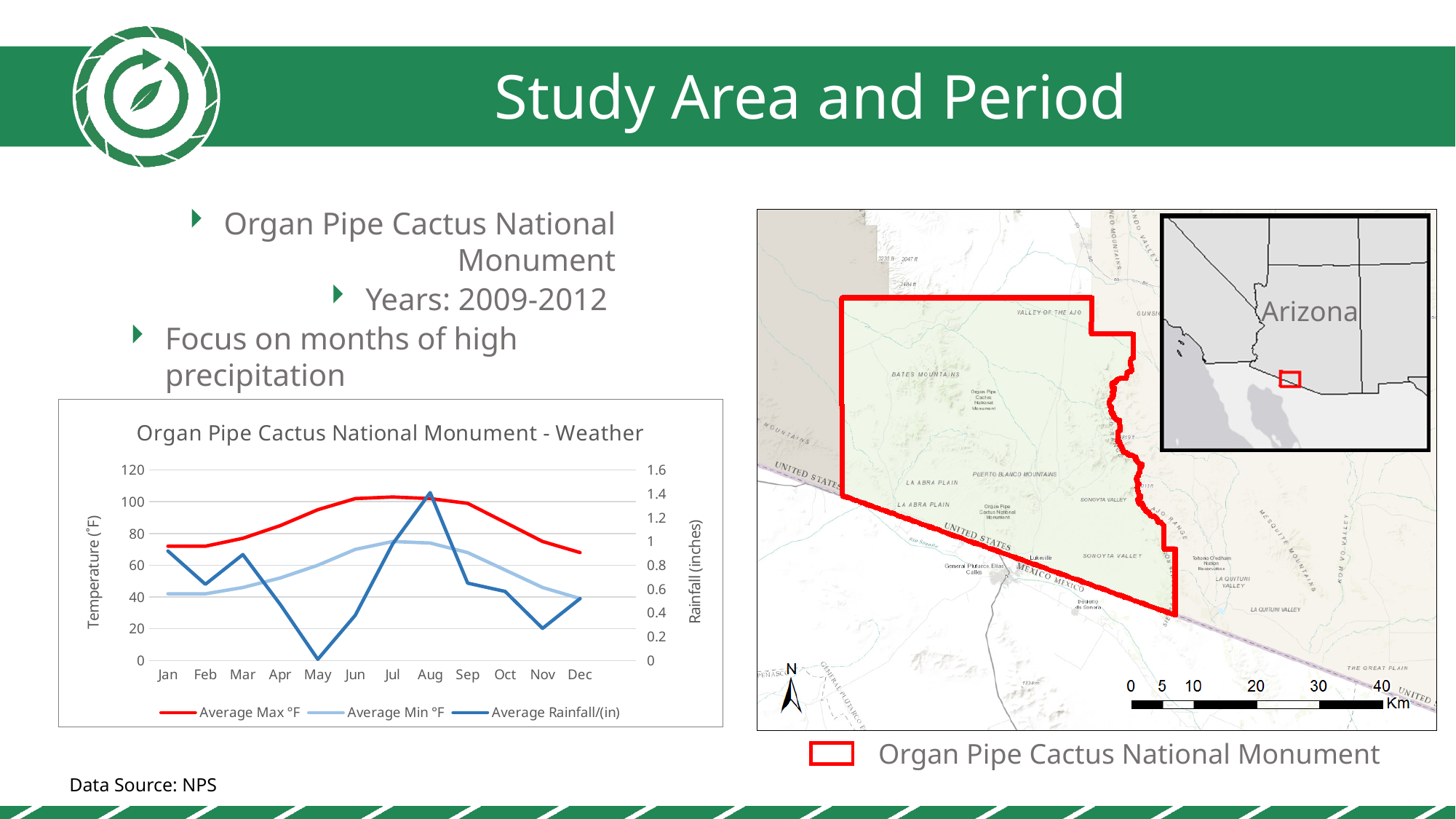
Is the Average Rainfall/(in) value for May greater or less than 0.2? less How many series does the legend of the weather chart list? 3 Is the Average Max °F value for Jan greater or less than 80? less Is the Average Rainfall/(in) value for Aug greater or less than 1.2? greater In which month is Average Rainfall/(in) lowest on the weather chart? May In which month is Average Rainfall/(in) highest on the weather chart? Aug Does the Average Max °F series rise or fall from Aug to Dec? fall What is the label of the right-hand vertical axis on the weather chart? Rainfall (inches) Which month has the larger Average Rainfall/(in) value, Jan or Nov? Jan How many months are plotted along the x axis of the weather chart? 12 What kind of chart is the 'Organ Pipe Cactus National Monument - Weather' chart? line chart